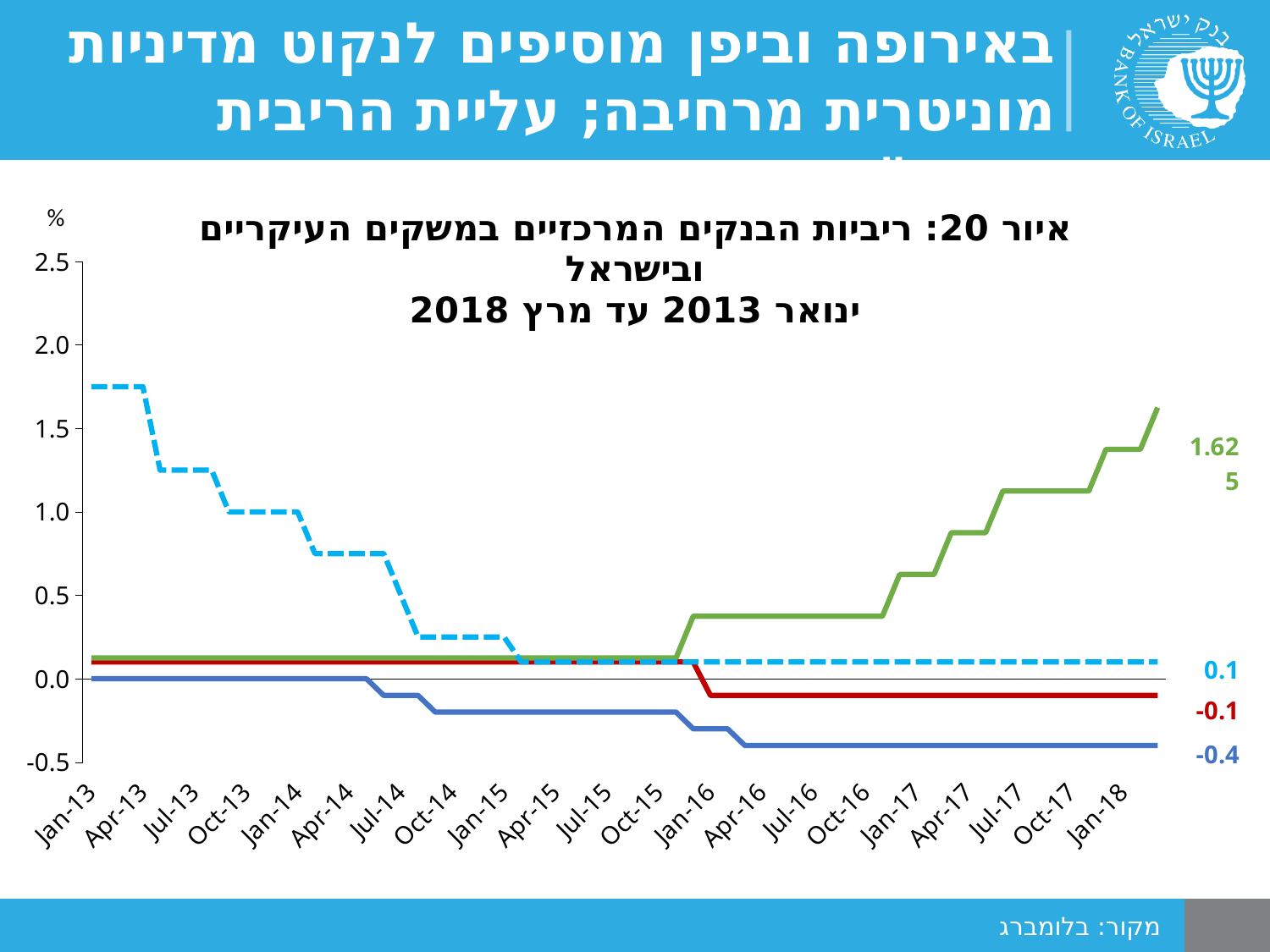
What is the final value labelled at the end of the dark-blue solid line? -0.4 What unit is shown on the vertical axis of the chart? % Which line has the highest value at the end of the period (Jan-18)? the green solid line Which line has the lowest value at the end of the period (Jan-18)? the dark-blue solid line What is the final value labelled at the end of the green solid line? 1.625 Is the value of the light-blue dashed line at Jan-13 greater or less than 1.5? greater How many lines are plotted on the chart? 4 What is the final value labelled at the end of the light-blue dashed line? 0.1 What type of chart is shown on the slide? line chart What is the final value labelled at the end of the red solid line? -0.1 Does the green solid line rise or fall over the period from Jan-16 to Jan-18? rise What is the difference between the end values of the red line (-0.1) and the dark-blue solid line (-0.4)? 0.3